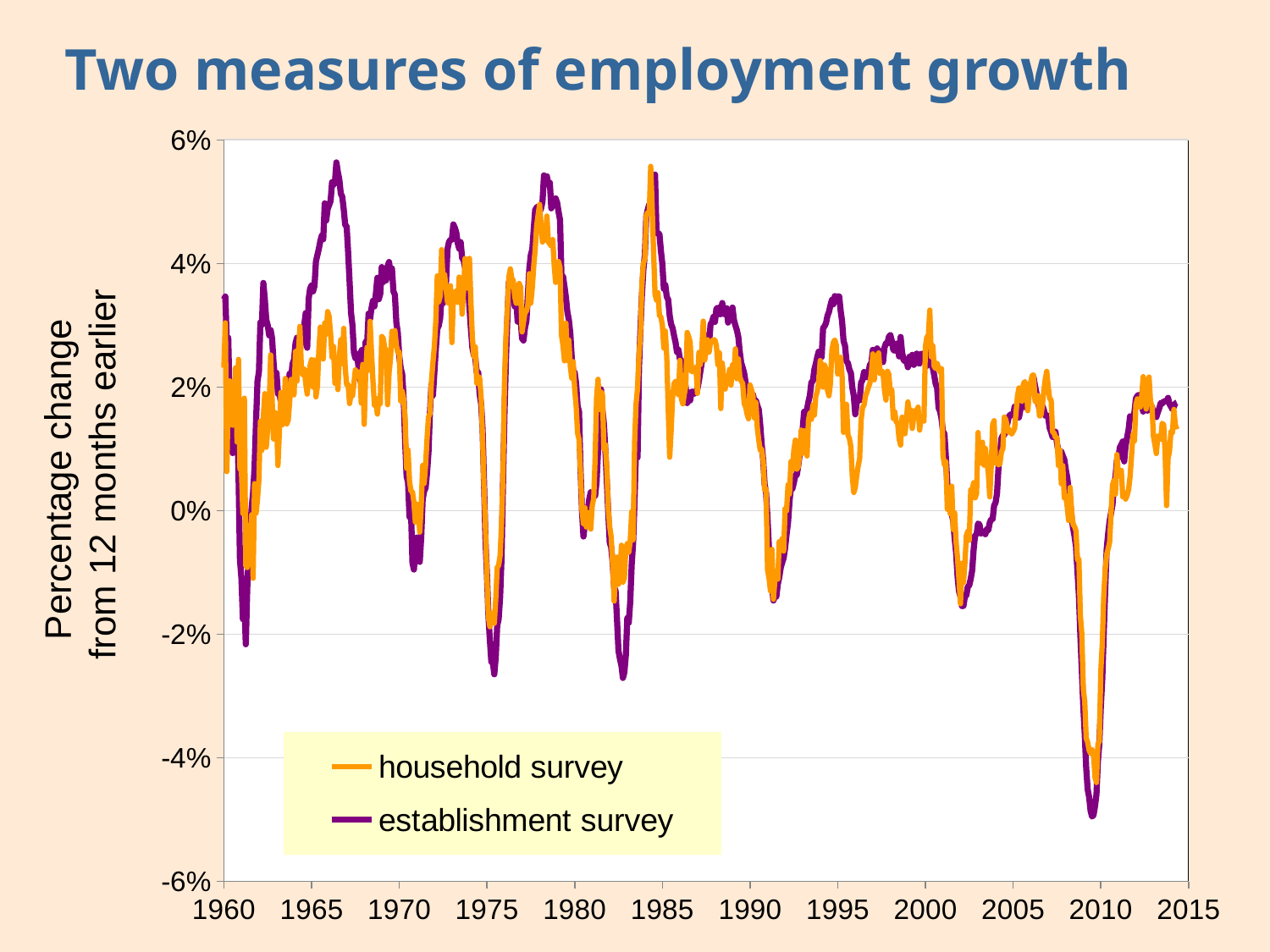
Is the household survey value around 1966 greater or less than 4%? less Is the peak of the establishment survey around 1966 greater or less than 4%? greater Which series is drawn in purple? establishment survey Around 1966, which series is higher, the household survey or the establishment survey? establishment survey What is the title of the chart? Two measures of employment growth At the trough around 1975, which series is lower, the household survey or the establishment survey? establishment survey Is the establishment survey trough around 1983 greater or less than -2%? less What kind of chart is shown on the slide? line chart Around which year does the establishment survey reach its lowest value? 2010 How many series does the legend list? 2